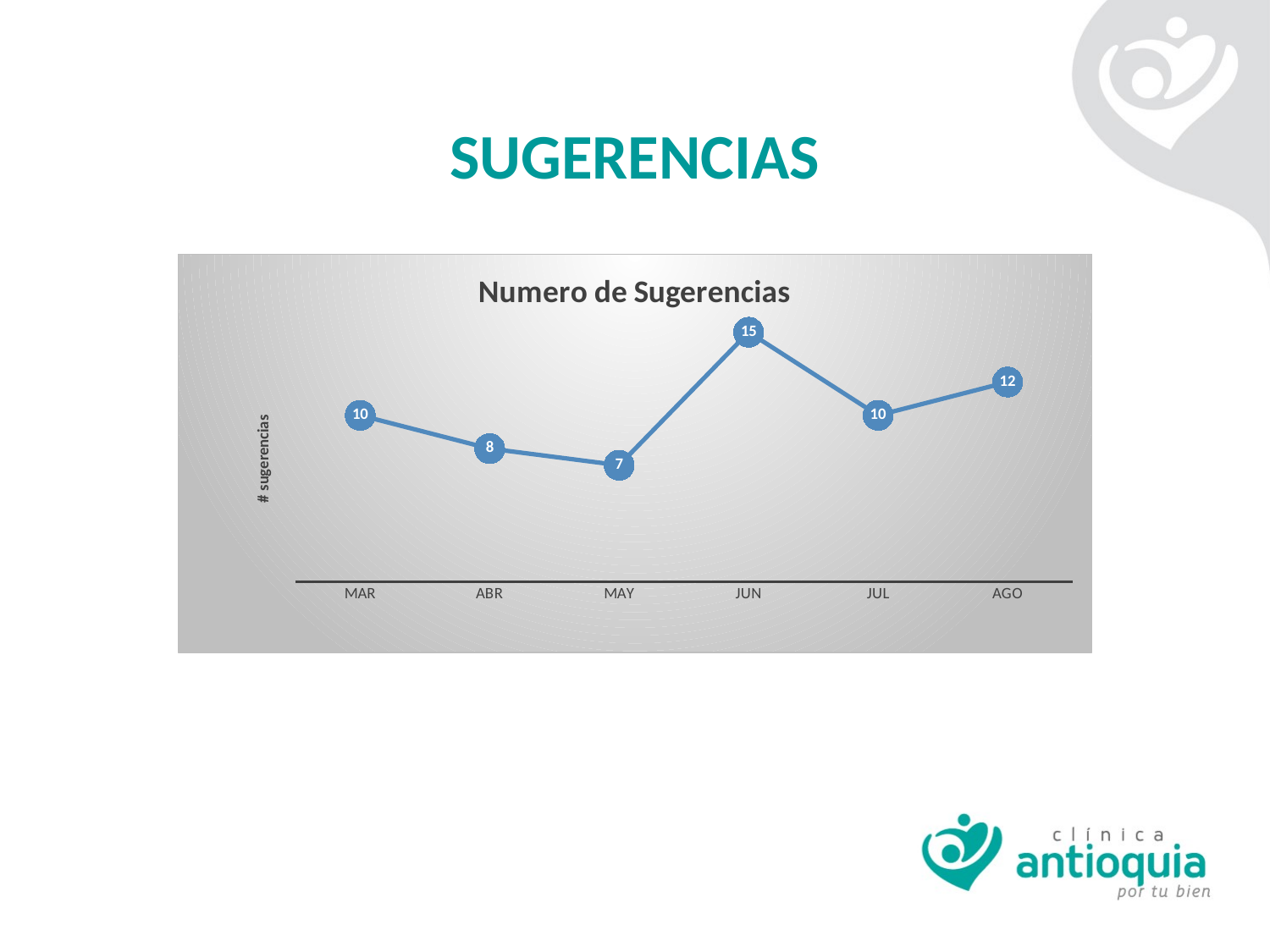
How many months are plotted on the x axis of the chart? 6 What is the value for JUN in the Numero de Sugerencias chart? 15 What is the difference between the values for AGO and JUL? 2 What is the value for ABR in the Numero de Sugerencias chart? 8 What is the value for MAY in the Numero de Sugerencias chart? 7 Which month has the highest number of suggestions? JUN Which is larger, the value for MAR or the value for ABR? MAR What is the difference between the values for JUN and MAY? 8 Which month has the lowest number of suggestions? MAY What kind of chart is shown on the slide? line chart What is the value for AGO in the Numero de Sugerencias chart? 12 What is the title of the chart? Numero de Sugerencias